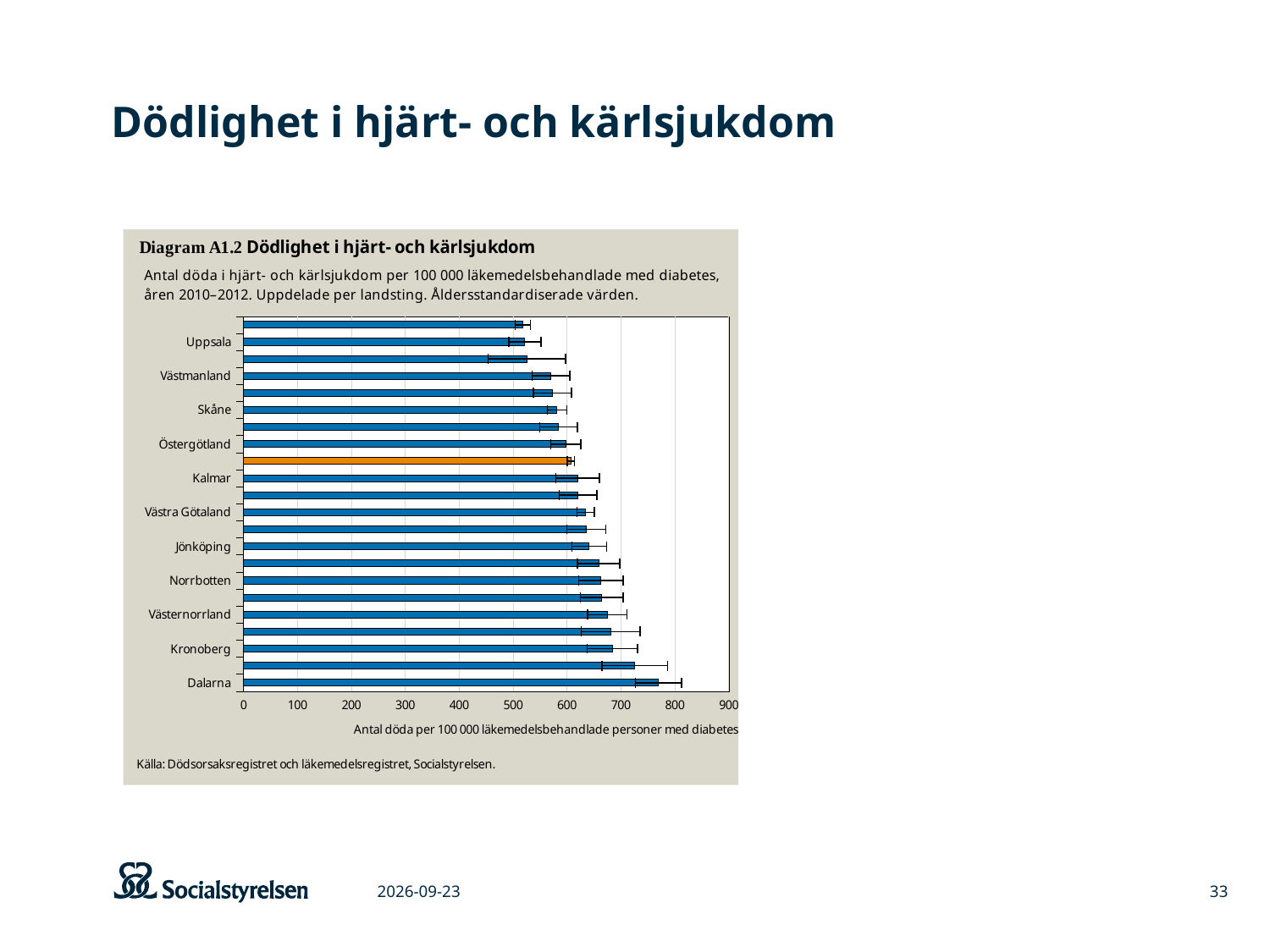
Do the bar values increase or decrease going from the top of the chart to the bottom? increase Is the value for Dalarna greater or less than 700? greater Is the value for Uppsala greater or less than 600? less Is the value for Norrbotten greater or less than 700? less Which has the larger value, Kronoberg or Skåne? Kronoberg Which of the labelled landsting has the highest value? Dalarna What kind of chart is shown on the slide? bar chart What is the label of the x axis? Antal döda per 100 000 läkemedelsbehandlade personer med diabetes What colour is the single bar that differs from the others? orange